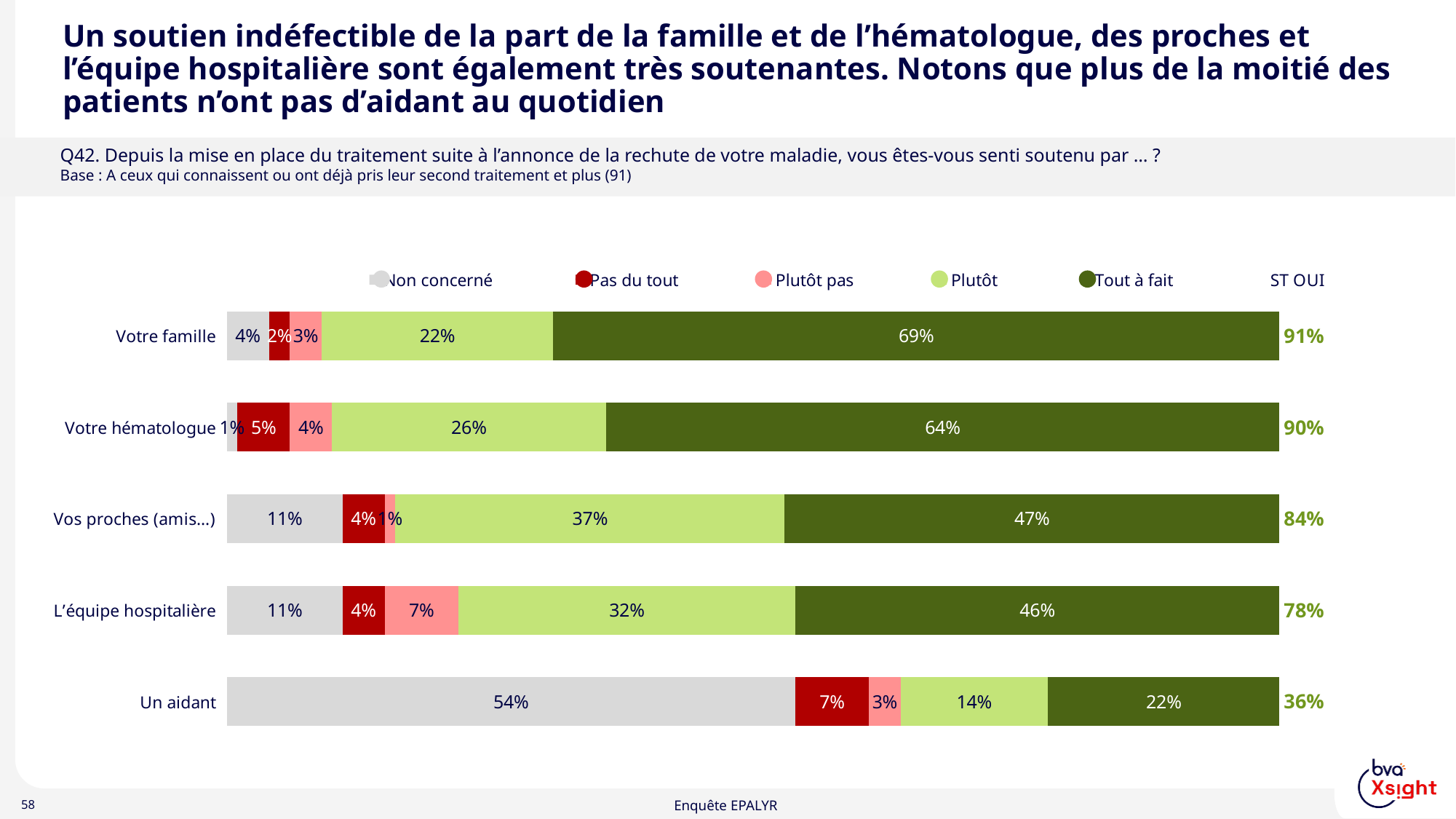
What is the "Non concerné" value for Un aidant? 54% What is the difference between the "Tout à fait" values for Votre famille and Votre hématologue? 5 percentage points What is the combined total of "Plutôt" and "Tout à fait" (ST OUI) for Vos proches (amis…)? 84% What percentage of respondents answered "Tout à fait" for Votre famille? 69% How many categories are shown in the chart? 5 What is the "Plutôt pas" value for L'équipe hospitalière? 7% What is the "Plutôt" value for Vos proches (amis…)? 37% Which category has the lowest "Tout à fait" value? Un aidant How many series does the legend list? 5 Which category has the highest "Tout à fait" value? Votre famille What kind of chart is shown on the slide? Stacked bar chart Which has the larger "Plutôt" value, Votre hématologue or Votre famille? Votre hématologue